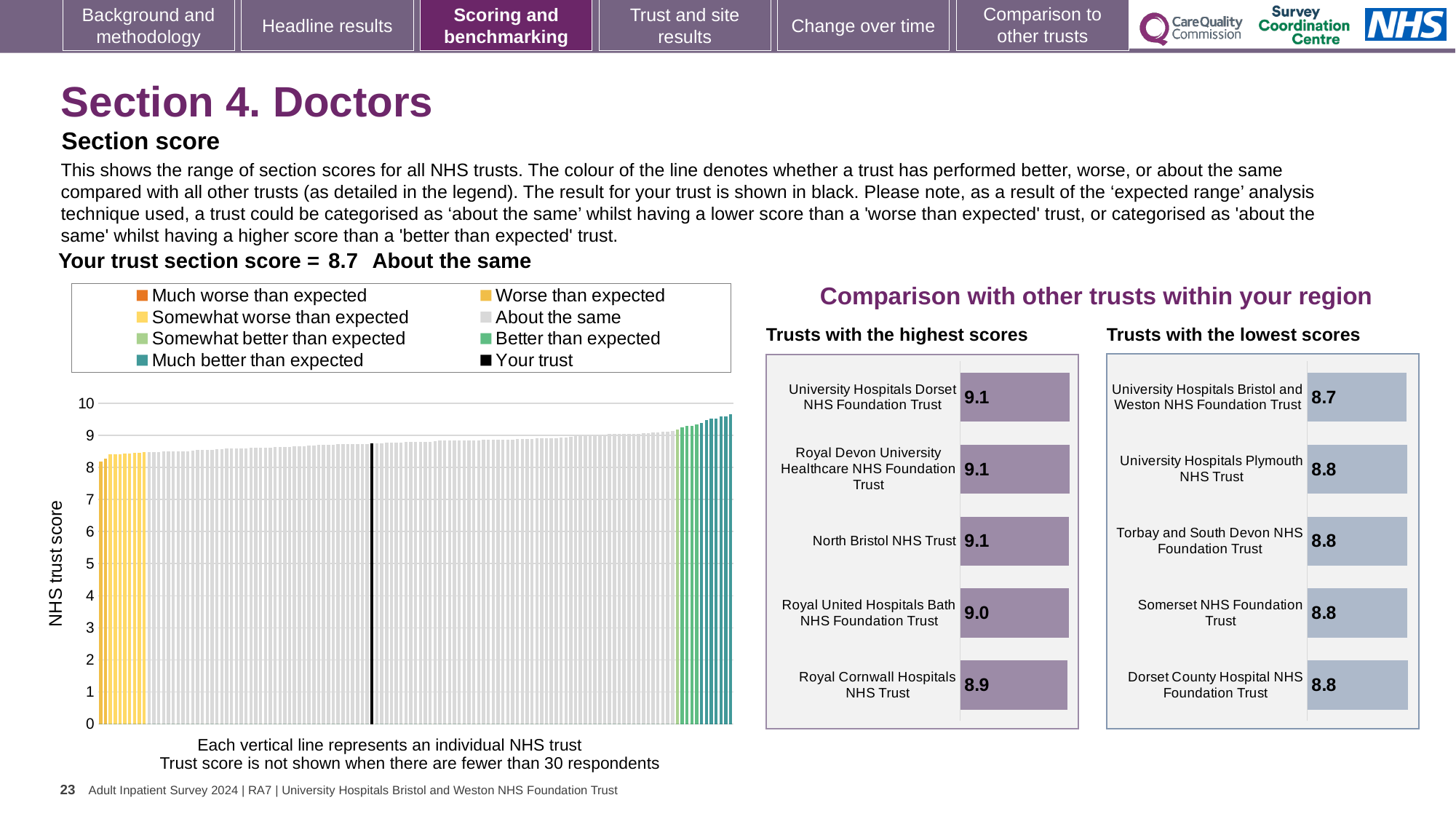
What is the y-axis title of the large chart on the left? NHS trust score In the 'Trusts with the highest scores' chart, what is the score for Royal Cornwall Hospitals NHS Trust? 8.9 In the 'Trusts with the highest scores' chart, what is the score for Royal United Hospitals Bath NHS Foundation Trust? 9.0 How many trusts are shown in the 'Trusts with the lowest scores' chart? 5 In the 'Trusts with the highest scores' chart, which trust has the lowest score? Royal Cornwall Hospitals NHS Trust In the 'Trusts with the highest scores' chart, which has the larger score: Royal United Hospitals Bath NHS Foundation Trust or Royal Cornwall Hospitals NHS Trust? Royal United Hospitals Bath NHS Foundation Trust In the 'Trusts with the lowest scores' chart, what is the score for University Hospitals Bristol and Weston NHS Foundation Trust? 8.7 What kind of chart is the large chart on the left showing NHS trust scores? Bar chart How many entries does the legend of the large chart on the left list? 8 In the 'Trusts with the highest scores' chart, what is the difference between the scores of University Hospitals Dorset NHS Foundation Trust and Royal Cornwall Hospitals NHS Trust? 0.2 How many trusts are shown in the 'Trusts with the highest scores' chart? 5 In the 'Trusts with the lowest scores' chart, which trust has the lowest score? University Hospitals Bristol and Weston NHS Foundation Trust